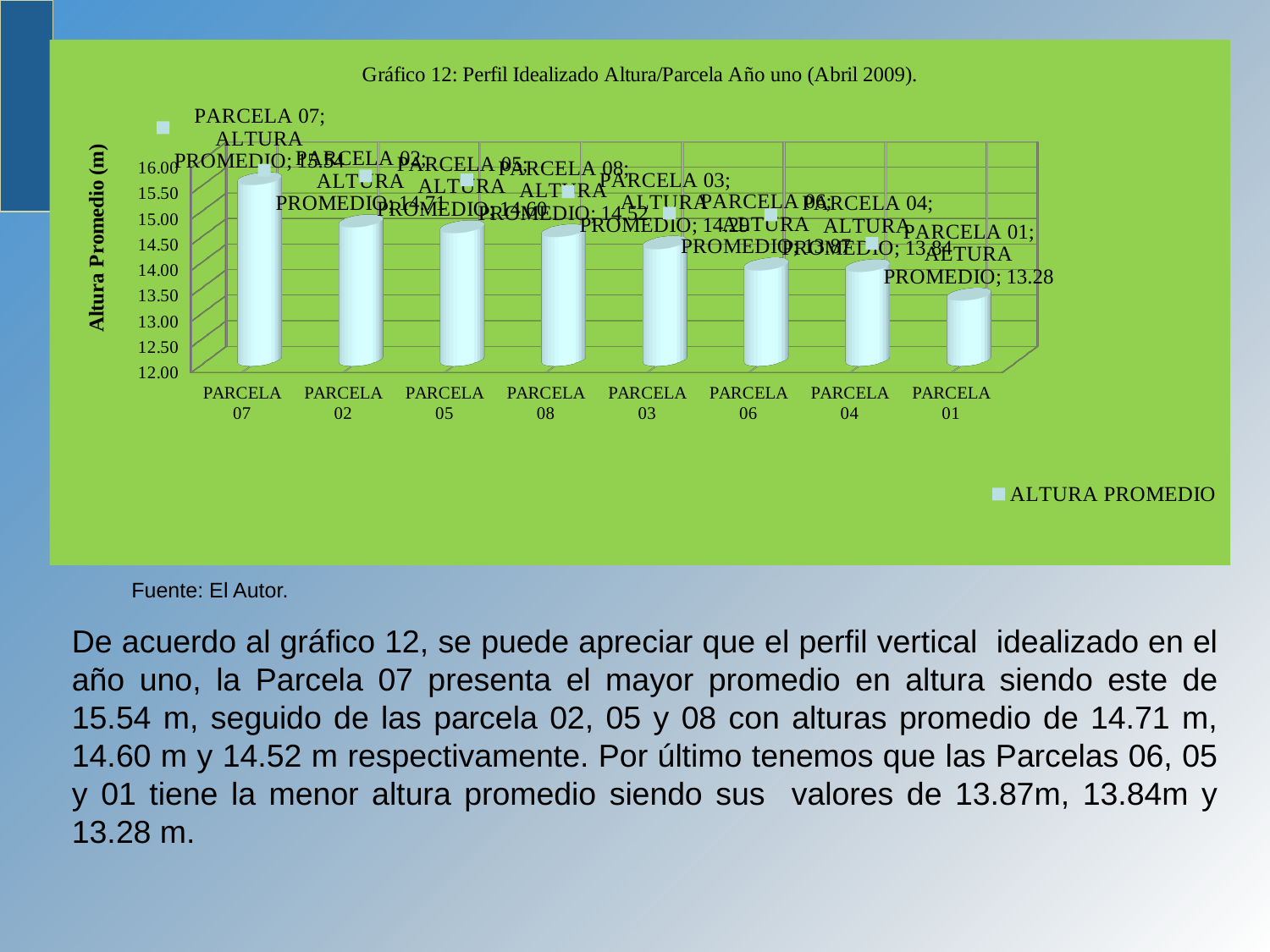
What kind of chart is shown on the slide? bar chart What is the title of the vertical axis? Altura Promedio (m) Which parcela has the highest ALTURA PROMEDIO? PARCELA 07 What is the ALTURA PROMEDIO value for PARCELA 07? 15.54 Do the bar values rise or fall from left to right along the x axis? fall How many series does the legend list? 1 What is the ALTURA PROMEDIO value for PARCELA 01? 13.28 What is the ALTURA PROMEDIO value for PARCELA 02? 14.71 How many parcelas (categories) are plotted on the chart? 8 What is the difference between the ALTURA PROMEDIO of PARCELA 07 and PARCELA 01? 2.26 Which parcela has the lowest ALTURA PROMEDIO? PARCELA 01 Which has a larger ALTURA PROMEDIO, PARCELA 02 or PARCELA 08? PARCELA 02